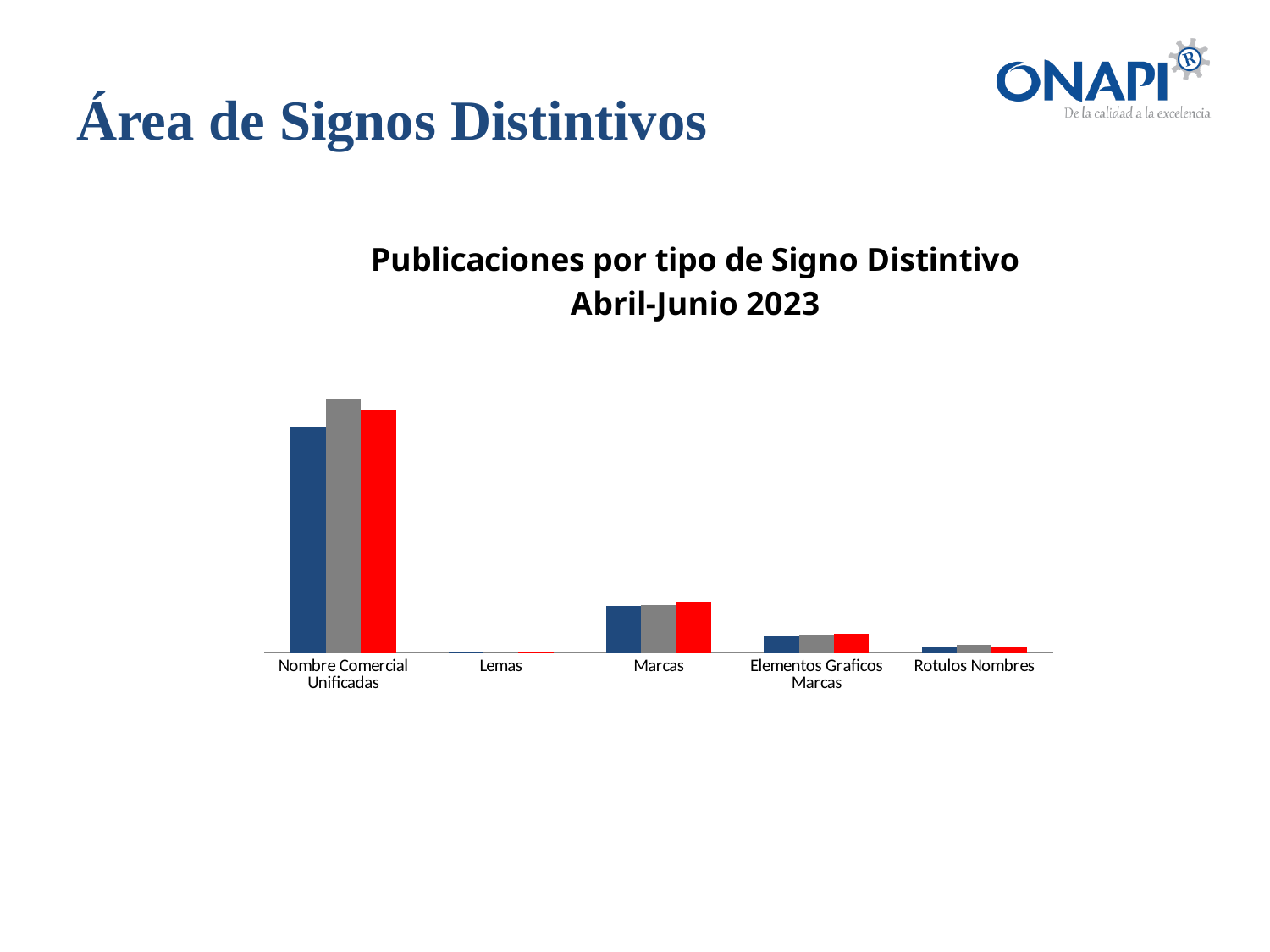
Which category has the lowest values in the chart? Lemas Which category has the second highest values in the chart? Marcas How many bars are plotted for each category in the chart? 3 Which colour bar is the tallest for Nombre Comercial Unificadas? Gray How many categories are shown on the x axis of the chart? 5 Which category has larger values, Elementos Graficos Marcas or Rotulos Nombres? Elementos Graficos Marcas Which category is listed first on the x axis of the chart? Nombre Comercial Unificadas What is the title of the chart? Publicaciones por tipo de Signo Distintivo Abril-Junio 2023 What kind of chart is shown on the slide? Bar chart Which category has larger values, Nombre Comercial Unificadas or Marcas? Nombre Comercial Unificadas Which category has larger values, Marcas or Elementos Graficos Marcas? Marcas Which category has the highest values in the chart? Nombre Comercial Unificadas